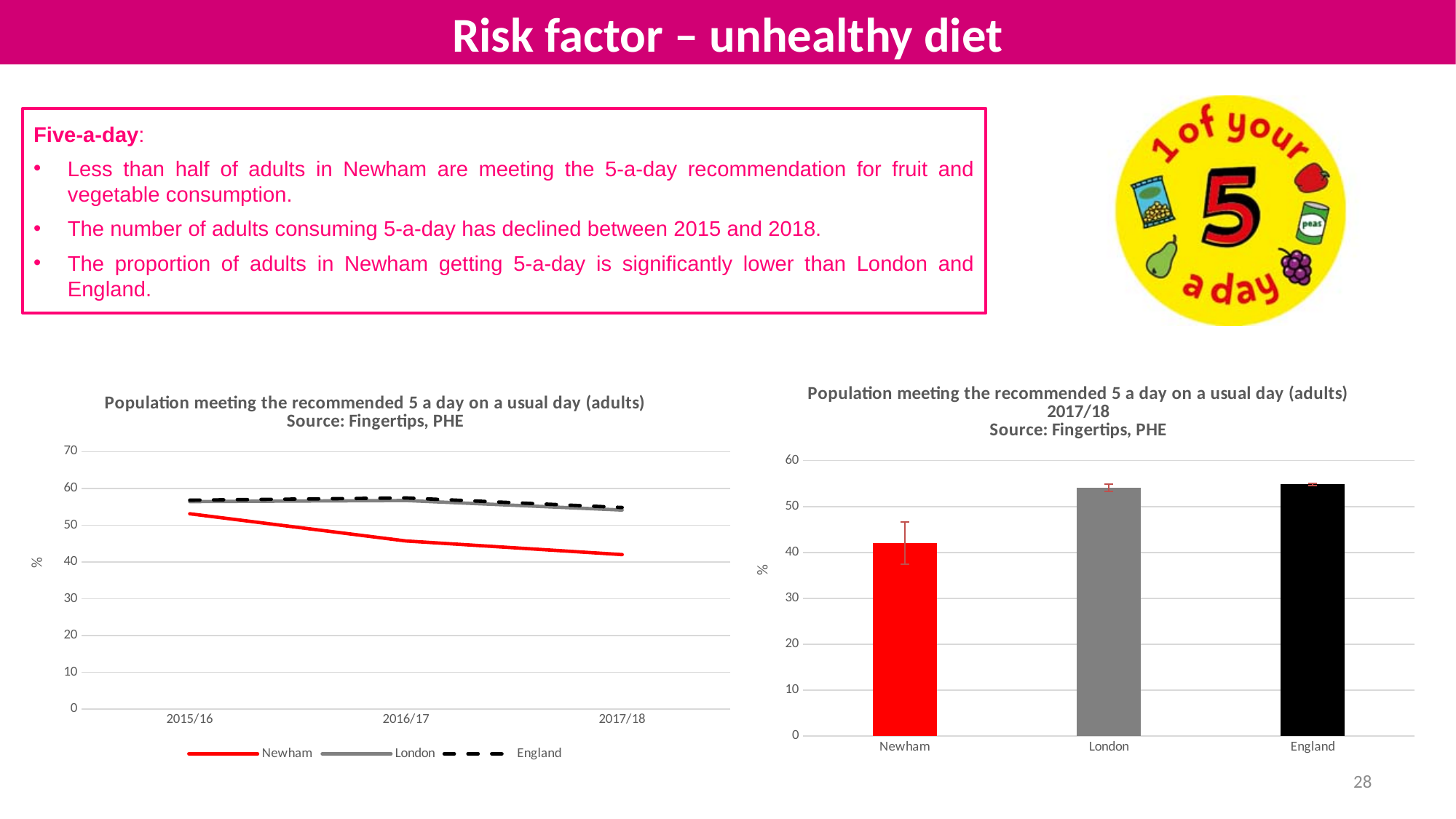
In the left line chart, is the value for Newham in 2015/16 greater or less than 50? greater In the right bar chart, how many categories are shown? 3 In the left line chart, which series has the lowest values across all years? Newham In the left line chart, how many series does the legend list? 3 In the left line chart, how many time periods are shown on the x axis? 3 In the right bar chart, is the value for Newham greater or less than 50? less In the left line chart, is the value for Newham in 2017/18 greater or less than 50? less In the left line chart, does the Newham line rise or fall from 2015/16 to 2017/18? fall What kind of chart is the left chart, 'Population meeting the recommended 5 a day on a usual day (adults)'? line chart In the right bar chart, which category has the lowest value? Newham What kind of chart is the right chart, 'Population meeting the recommended 5 a day on a usual day (adults) 2017/18'? bar chart